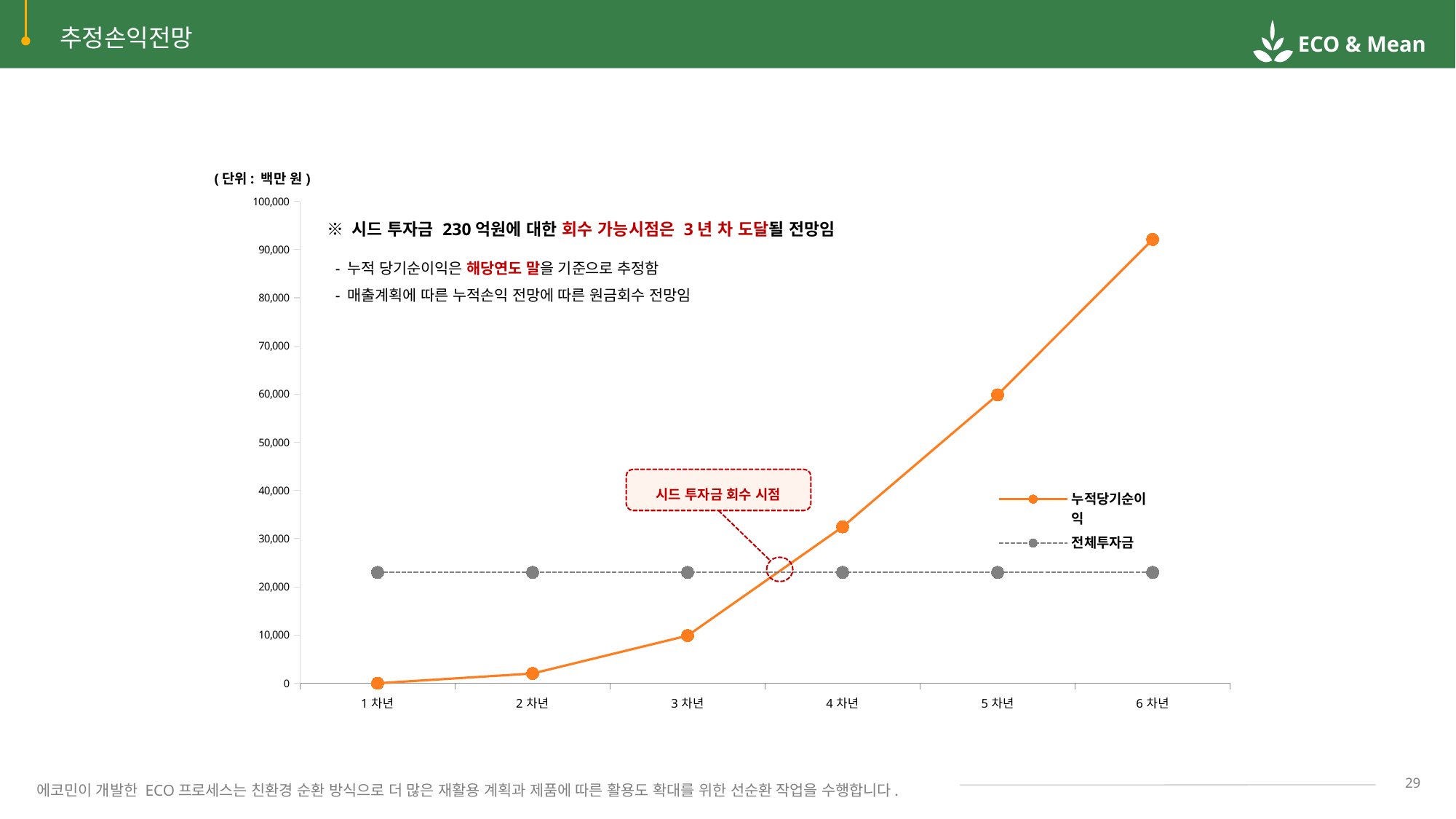
Is the value of 전체투자금 greater or less than 30,000? less Does 누적당기순이익 rise or fall from 1 차년 to 6 차년? rise What kind of chart is shown on the slide? line chart Is the value of 누적당기순이익 in 6 차년 greater or less than 80,000? greater Is the value of 누적당기순이익 in 3 차년 greater or less than 20,000? less How many series does the legend list? 2 What is the value of 누적당기순이익 in 1 차년? 0 What unit is stated for the chart values? 백만 원 Which year has the lowest value for 누적당기순이익? 1 차년 Which year has the highest value for 누적당기순이익? 6 차년 In 4 차년, which is larger: 누적당기순이익 or 전체투자금? 누적당기순이익 How many year categories are shown on the x axis? 6